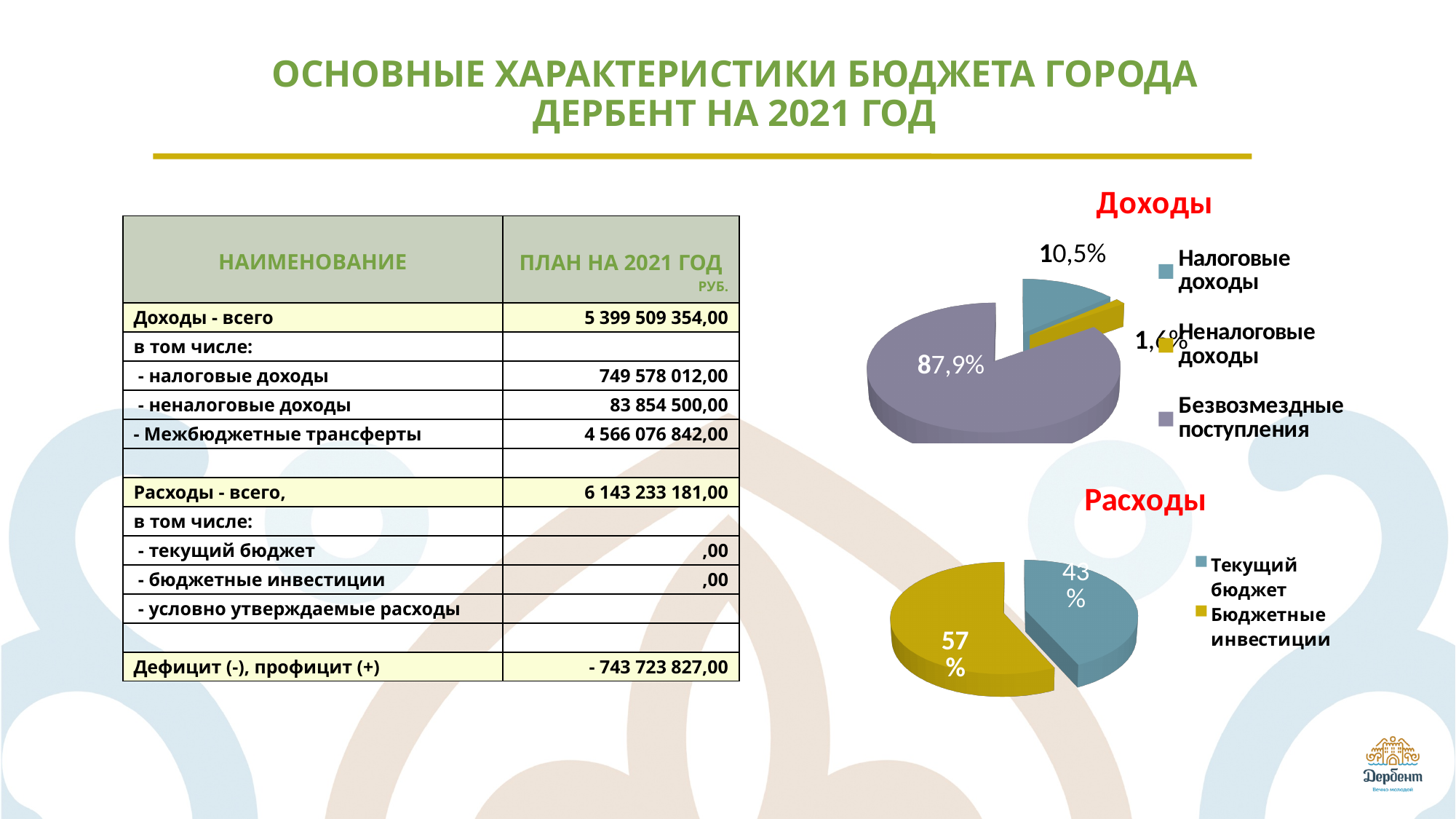
In the "Расходы" chart, what is the difference in percentage points between Бюджетные инвестиции and Текущий бюджет? 14 How many slices does the "Расходы" pie chart have? 2 In the "Расходы" chart, which is larger: Текущий бюджет or Бюджетные инвестиции? Бюджетные инвестиции How many entries does the legend of the "Доходы" chart list? 3 In the "Доходы" chart, what is the difference in percentage points between Безвозмездные поступления and Налоговые доходы? 77,4 What kind of chart is the "Доходы" chart? Pie chart In the "Доходы" chart, what share is shown for Налоговые доходы? 10,5% In the "Расходы" chart, what share is shown for Бюджетные инвестиции? 57% In the "Доходы" chart, which category has the largest slice? Безвозмездные поступления In the "Доходы" chart, which category has the smallest slice? Неналоговые доходы In the "Расходы" chart, what share is shown for Текущий бюджет? 43% In the "Доходы" chart, what share is shown for Безвозмездные поступления? 87,9%